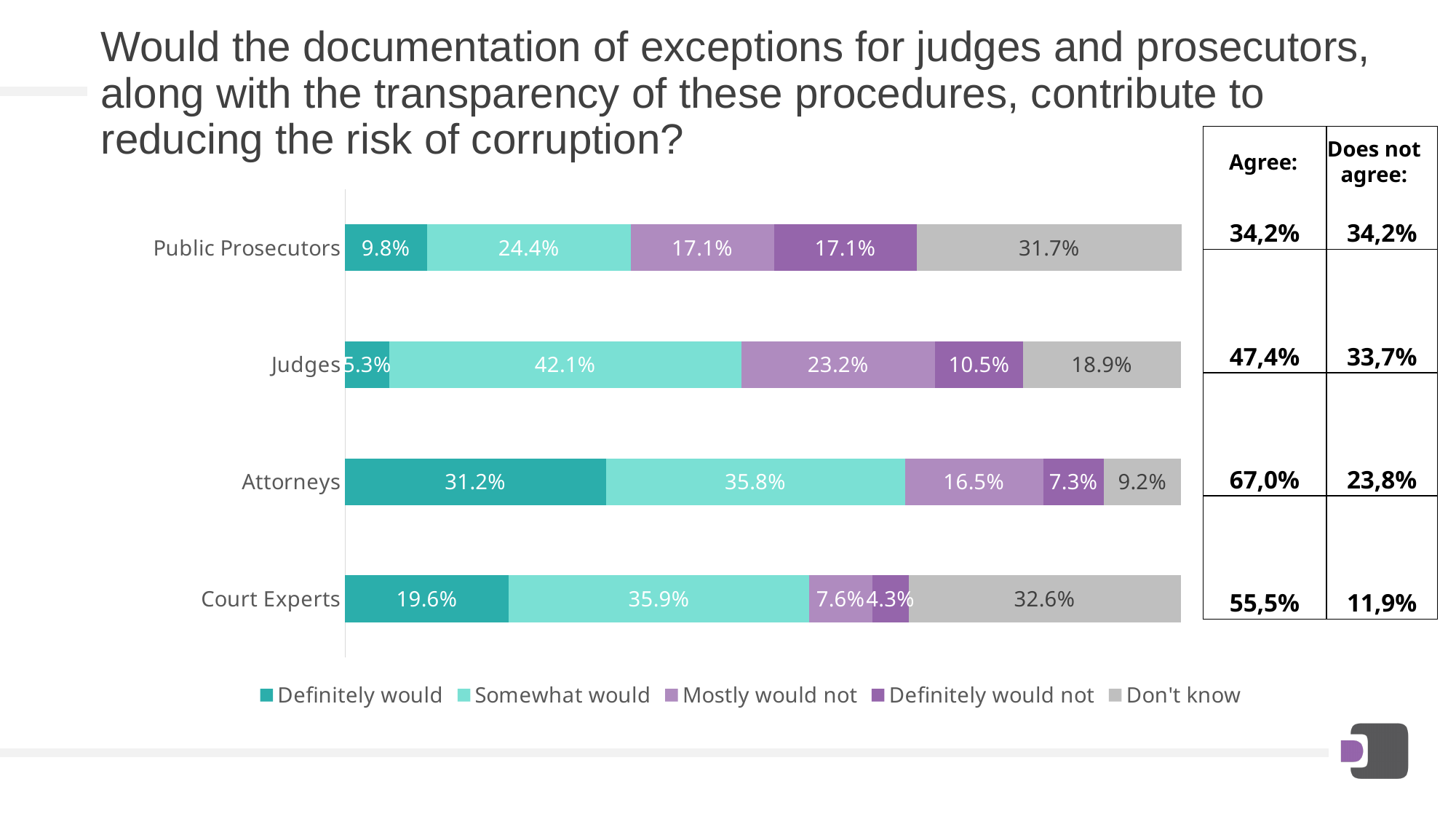
How many groups (categories) are shown in the chart? 4 What is the "Don't know" value for Court Experts? 32.6% What is the total of the stacked bar for Judges? 100% Which series is shown in grey in the legend? Don't know Which is larger: the "Definitely would not" value for Public Prosecutors or for Judges? Public Prosecutors What type of chart is shown on the slide? Stacked bar chart How many series does the legend list? 5 Which group has the highest "Definitely would" value? Attorneys What percentage of Judges answered "Mostly would not"? 23.2% Which group has the lowest "Don't know" value? Attorneys What percentage of Attorneys answered "Definitely would"? 31.2% What is the difference between the "Somewhat would" values for Judges and Public Prosecutors? 17.7 percentage points